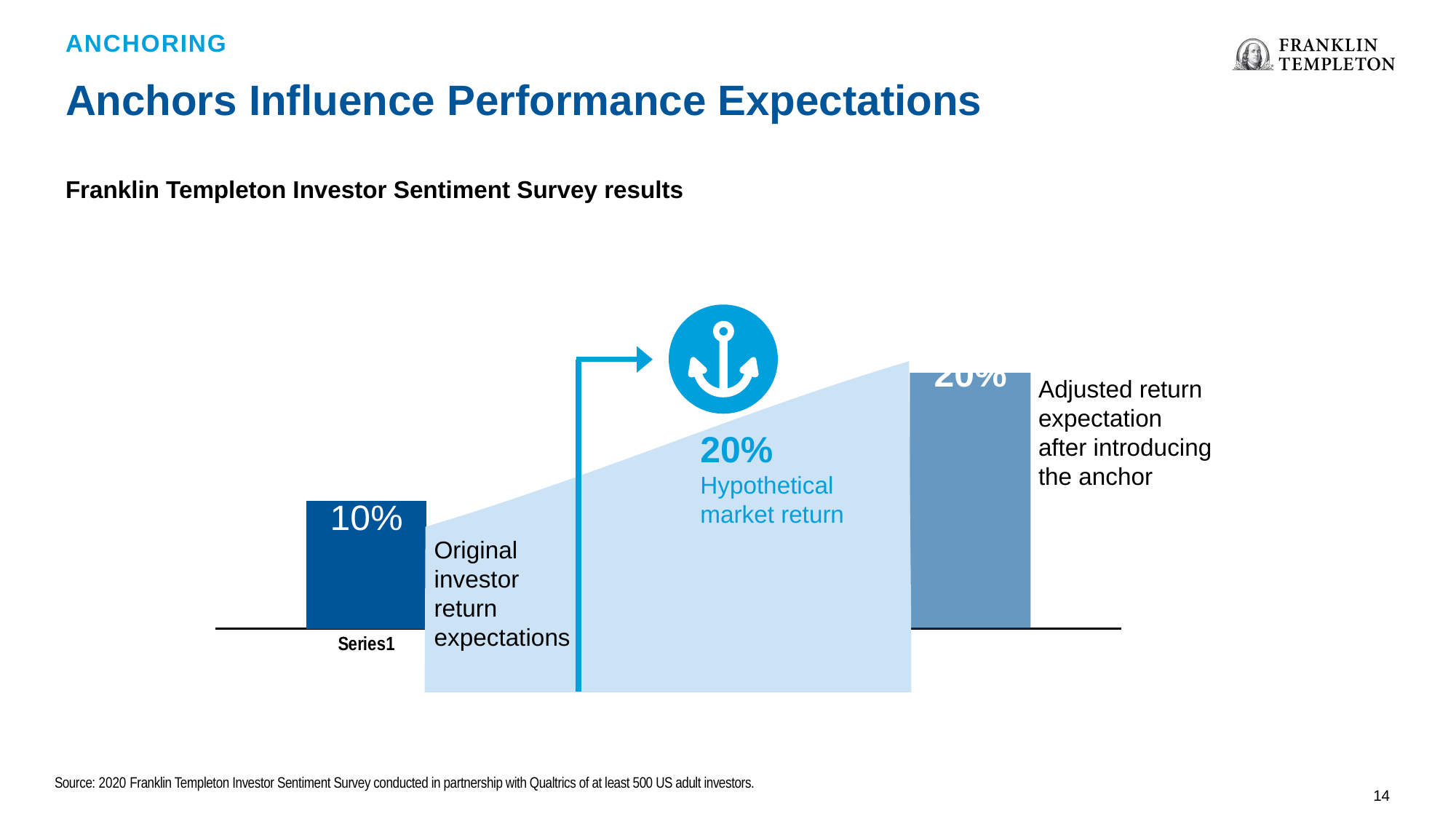
How many bars are plotted on the chart? 2 Which is larger: the original investor return expectation or the adjusted return expectation after introducing the anchor? Adjusted return expectation after introducing the anchor What is the value shown for the adjusted return expectation after introducing the anchor? 20% What kind of chart is shown on the slide? Bar chart What is the subtitle above the chart? Franklin Templeton Investor Sentiment Survey results What hypothetical market return is shown on the chart? 20% What is the difference between the adjusted return expectation and the original investor return expectation? 10% Which bar is the lowest on the chart? Original investor return expectations Do the bar values rise or fall from left to right? Rise What axis label appears beneath the first bar? Series1 Which bar is the highest on the chart? Adjusted return expectation after introducing the anchor What is the value shown for the original investor return expectations bar? 10%